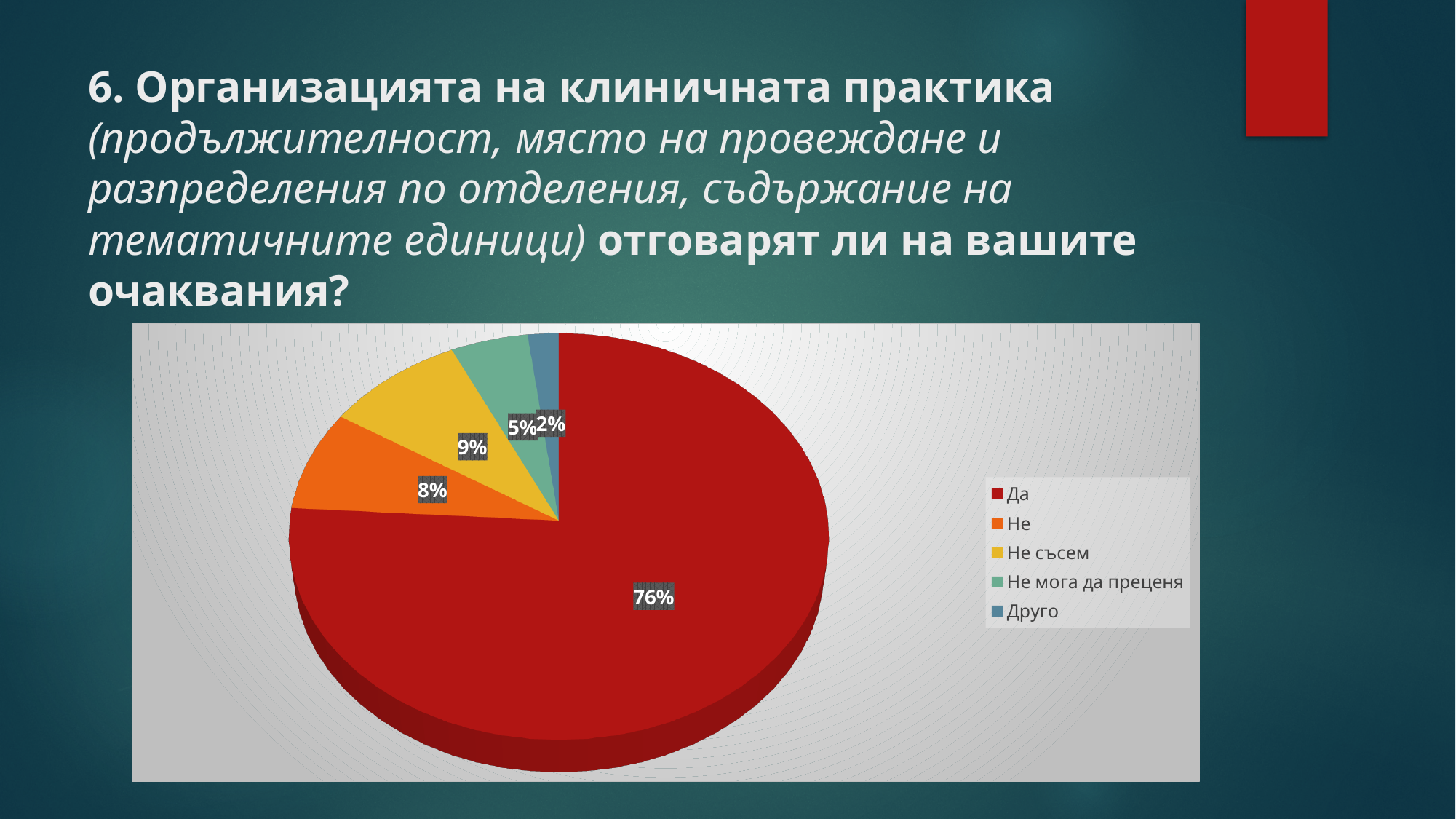
What is the difference between the values for "Да" and "Не"? 68% What colour is the "Да" slice in the pie chart? Red What share of the pie does the "Да" slice represent? 76% Which is larger, the value for "Не съсем" or the value for "Не"? Не съсем How many categories does the pie chart show? 5 What is the value shown for "Не мога да преценя"? 5% What is the value shown for "Не съсем"? 9% Which category has the largest slice of the pie? Да What is the value shown for "Друго"? 2% What is the value shown for "Не"? 8% Which category has the smallest slice of the pie? Друго What kind of chart is shown on the slide? Pie chart